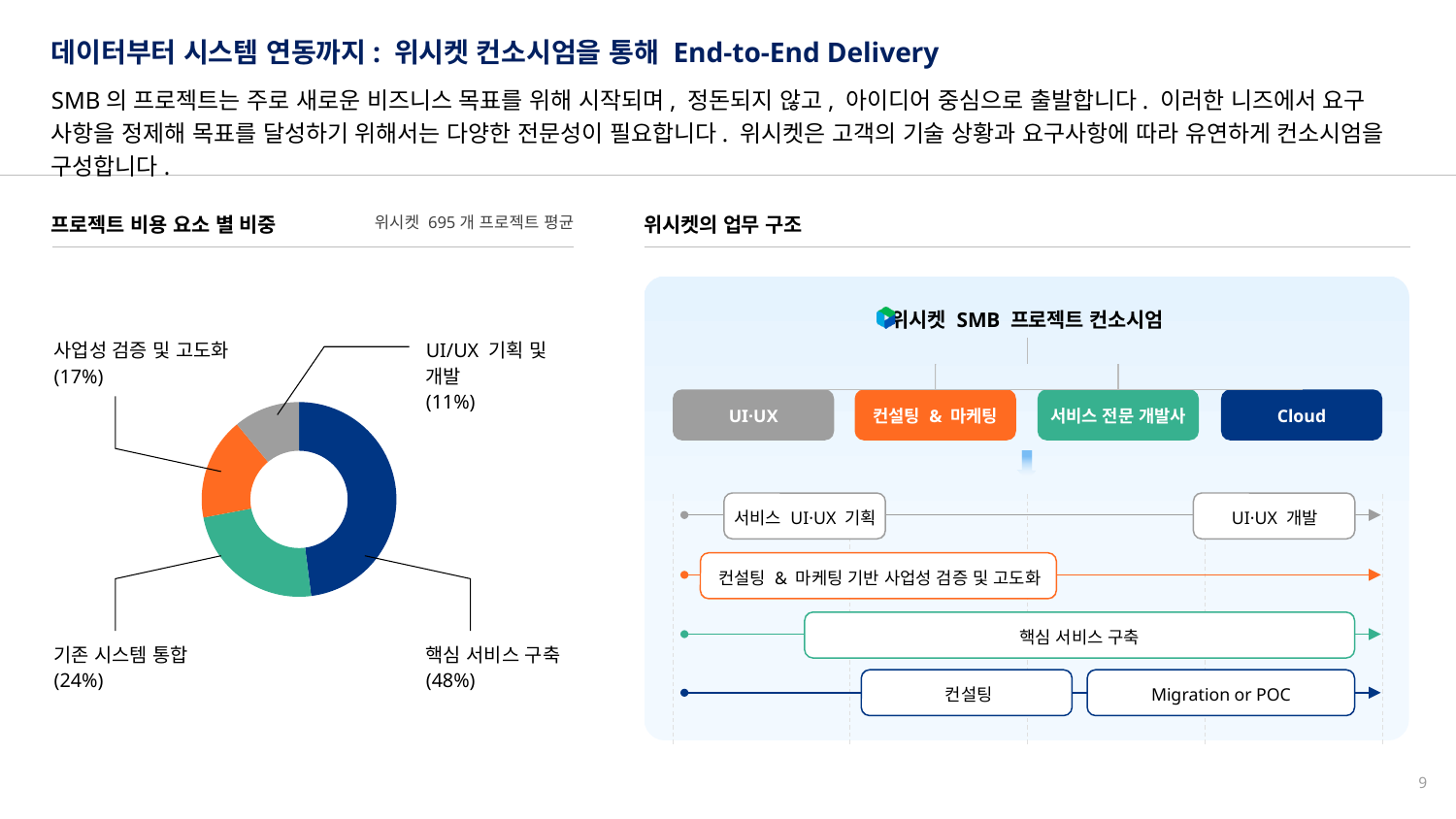
How many categories are shown in the '프로젝트 비용 요소 별 비중' chart? 4 What type of chart is shown under the title '프로젝트 비용 요소 별 비중'? Donut (pie) chart In the '프로젝트 비용 요소 별 비중' chart, what share does '사업성 검증 및 고도화' have? 17% In the '프로젝트 비용 요소 별 비중' chart, what is the difference between the shares of '핵심 서비스 구축' and '기존 시스템 통합'? 24% According to the note next to the '프로젝트 비용 요소 별 비중' chart title, how many projects is the average based on? 695개 Which category has the smallest share in the '프로젝트 비용 요소 별 비중' chart? UI/UX 기획 및 개발 In the '프로젝트 비용 요소 별 비중' chart, what is the difference between the shares of '기존 시스템 통합' and '사업성 검증 및 고도화'? 7% In the '프로젝트 비용 요소 별 비중' chart, what share does '핵심 서비스 구축' have? 48% In the '프로젝트 비용 요소 별 비중' chart, what share does '기존 시스템 통합' have? 24% Which category has the largest share in the '프로젝트 비용 요소 별 비중' chart? 핵심 서비스 구축 In the '프로젝트 비용 요소 별 비중' chart, which is larger: '사업성 검증 및 고도화' or 'UI/UX 기획 및 개발'? 사업성 검증 및 고도화 In the '프로젝트 비용 요소 별 비중' chart, what share does 'UI/UX 기획 및 개발' have? 11%